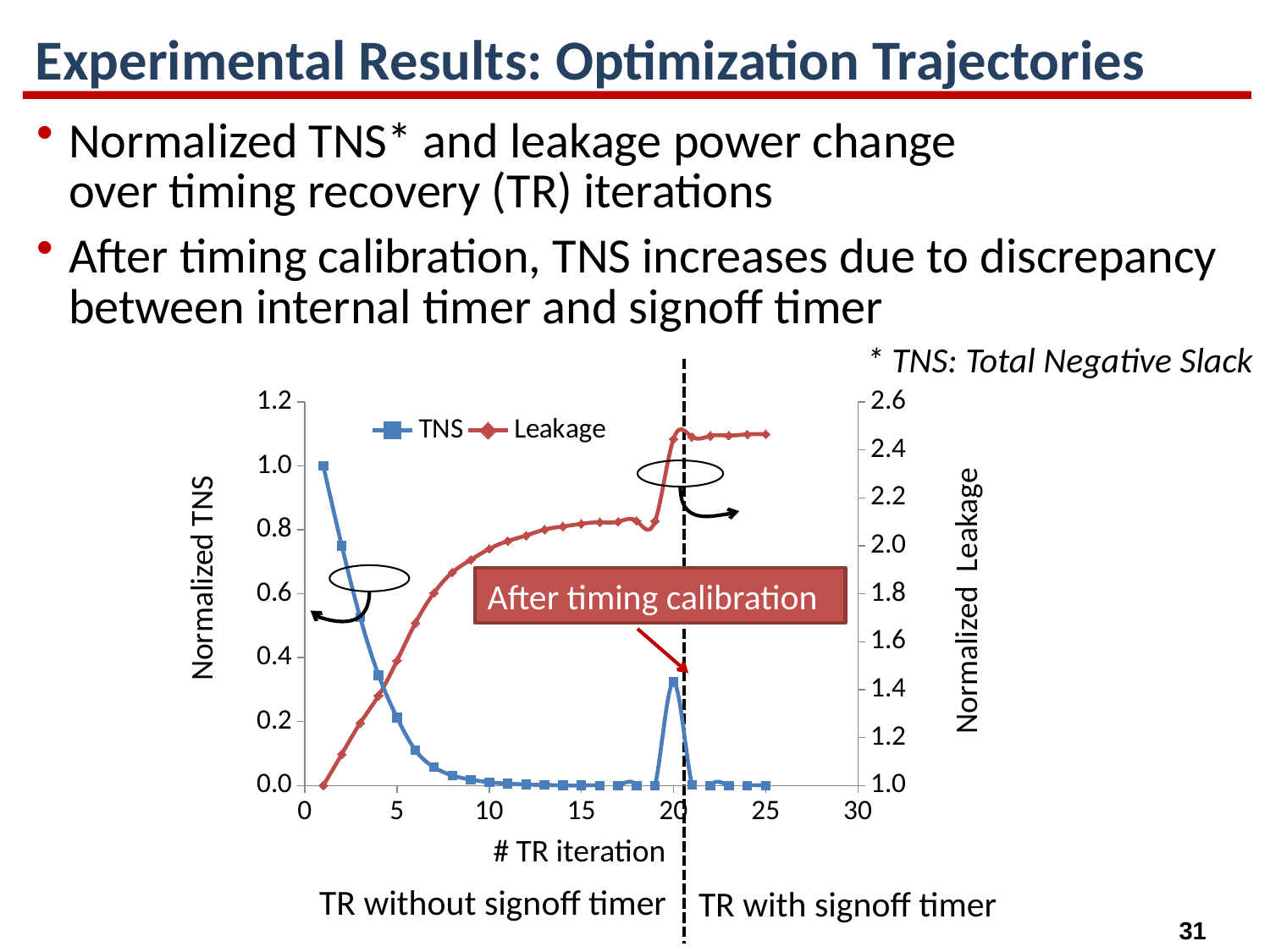
At which TR iteration is the Leakage series at its lowest? 1 Does the Leakage series rise or fall between TR iteration 1 and TR iteration 10? rise How many series does the chart legend list? 2 Is the Normalized TNS value at TR iteration 5 greater or less than 0.4? less What kind of chart is shown on the slide? line chart Is the Normalized Leakage value at TR iteration 25 greater or less than 2.2? greater At which TR iteration is the TNS series at its highest? 1 Which is larger, the Normalized TNS value at TR iteration 1 or at TR iteration 5? TR iteration 1 What is the Normalized Leakage value at TR iteration 1? 1.0 What are the two series named in the chart legend? TNS and Leakage What is the Normalized TNS value at TR iteration 1? 1.0 What is the title of the x axis of the chart? # TR iteration